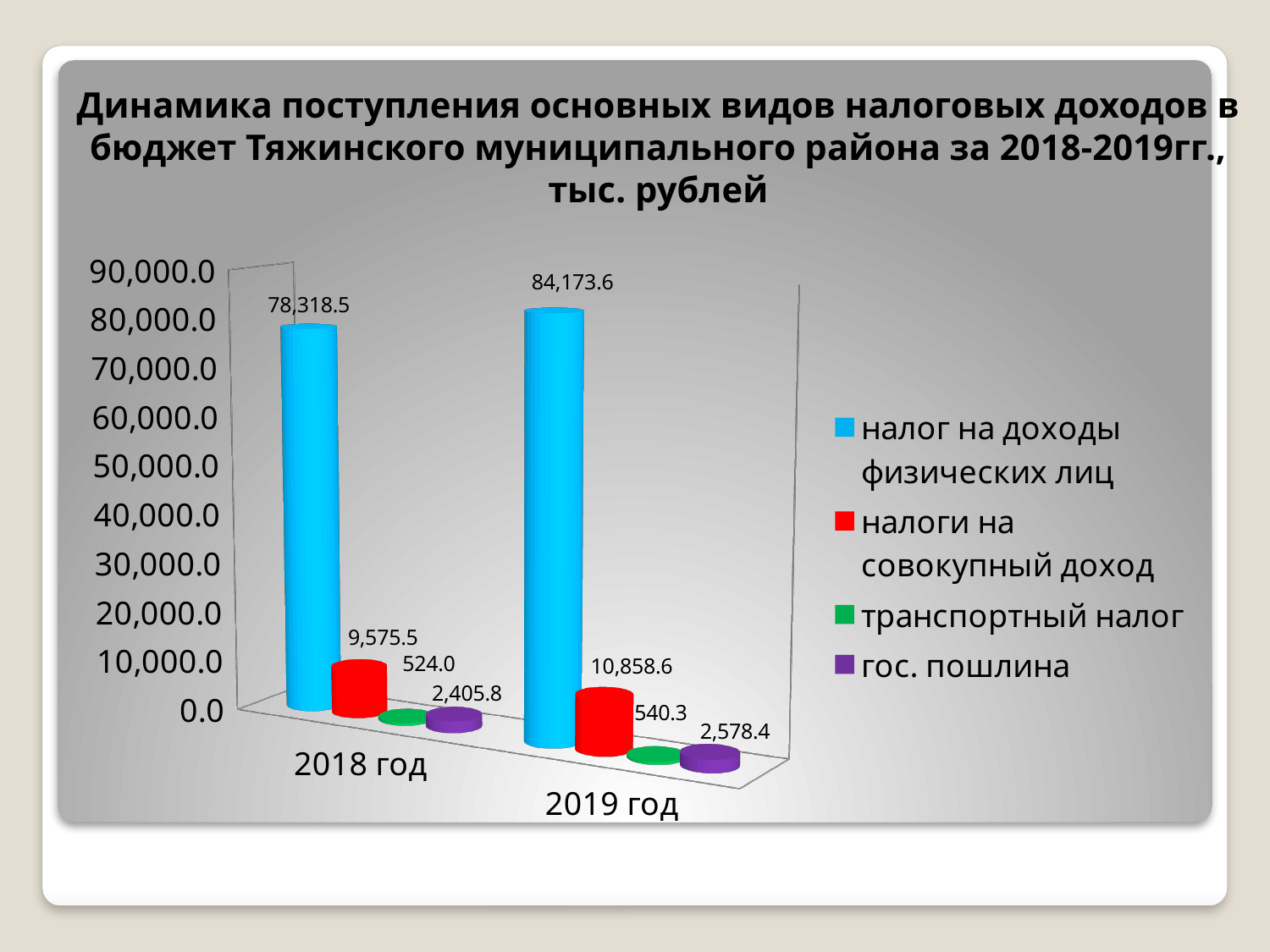
What is the value for налог на доходы физических лиц in 2018 год? 78,318.5 What is the value for гос. пошлина in 2019 год? 2,578.4 By how much did налог на доходы физических лиц change from 2018 год to 2019 год? 5,855.1 What is the value for транспортный налог in 2018 год? 524.0 What is the difference between налоги на совокупный доход in 2019 год and in 2018 год? 1,283.1 Which series has the highest value in 2019 год? налог на доходы физических лиц What is the value for налоги на совокупный доход in 2019 год? 10,858.6 Which is larger: гос. пошлина in 2018 год or in 2019 год? 2019 год Which series has the lowest value in 2018 год? транспортный налог What is the value for налог на доходы физических лиц in 2019 год? 84,173.6 How many series does the legend list? 4 What kind of chart is shown on the slide? bar chart